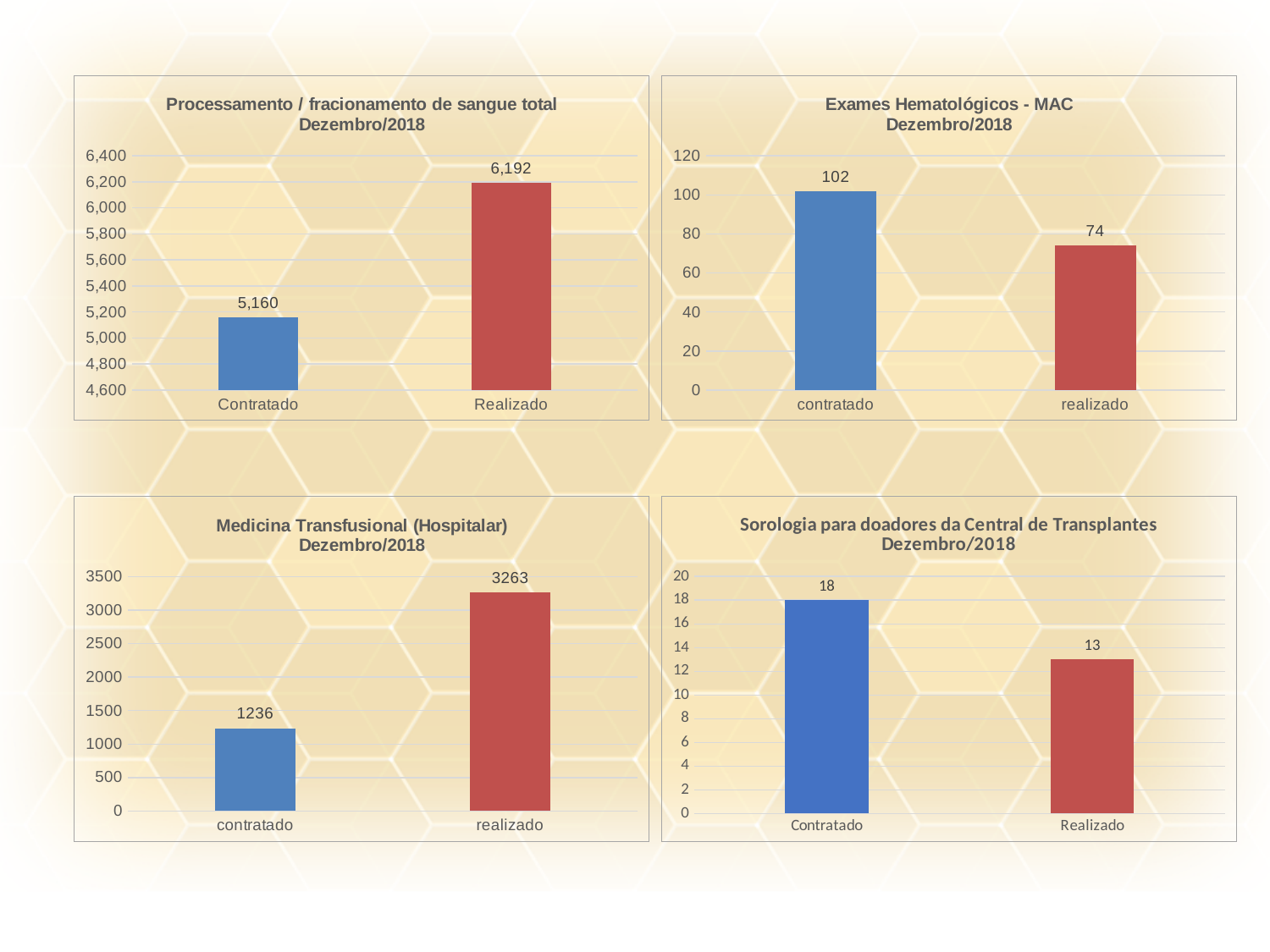
In the 'Medicina Transfusional (Hospitalar)' chart, what is the value for realizado? 3263 In the 'Medicina Transfusional (Hospitalar)' chart, which is larger, contratado or realizado? realizado In the 'Processamento / fracionamento de sangue total' chart, what is the value for Realizado? 6,192 In the 'Exames Hematológicos - MAC' chart, what is the difference between contratado and realizado? 28 What kind of chart is the 'Medicina Transfusional (Hospitalar)' chart? bar chart In the 'Sorologia para doadores da Central de Transplantes' chart, which category is highest? Contratado In the 'Exames Hematológicos - MAC' chart, which category is lowest? realizado In the 'Processamento / fracionamento de sangue total' chart, what is the value for Contratado? 5,160 In the 'Sorologia para doadores da Central de Transplantes' chart, what is the value for Realizado? 13 How many categories does the 'Sorologia para doadores da Central de Transplantes' chart show? 2 In the 'Processamento / fracionamento de sangue total' chart, what is the difference between Realizado and Contratado? 1,032 In the 'Exames Hematológicos - MAC' chart, what is the value for contratado? 102